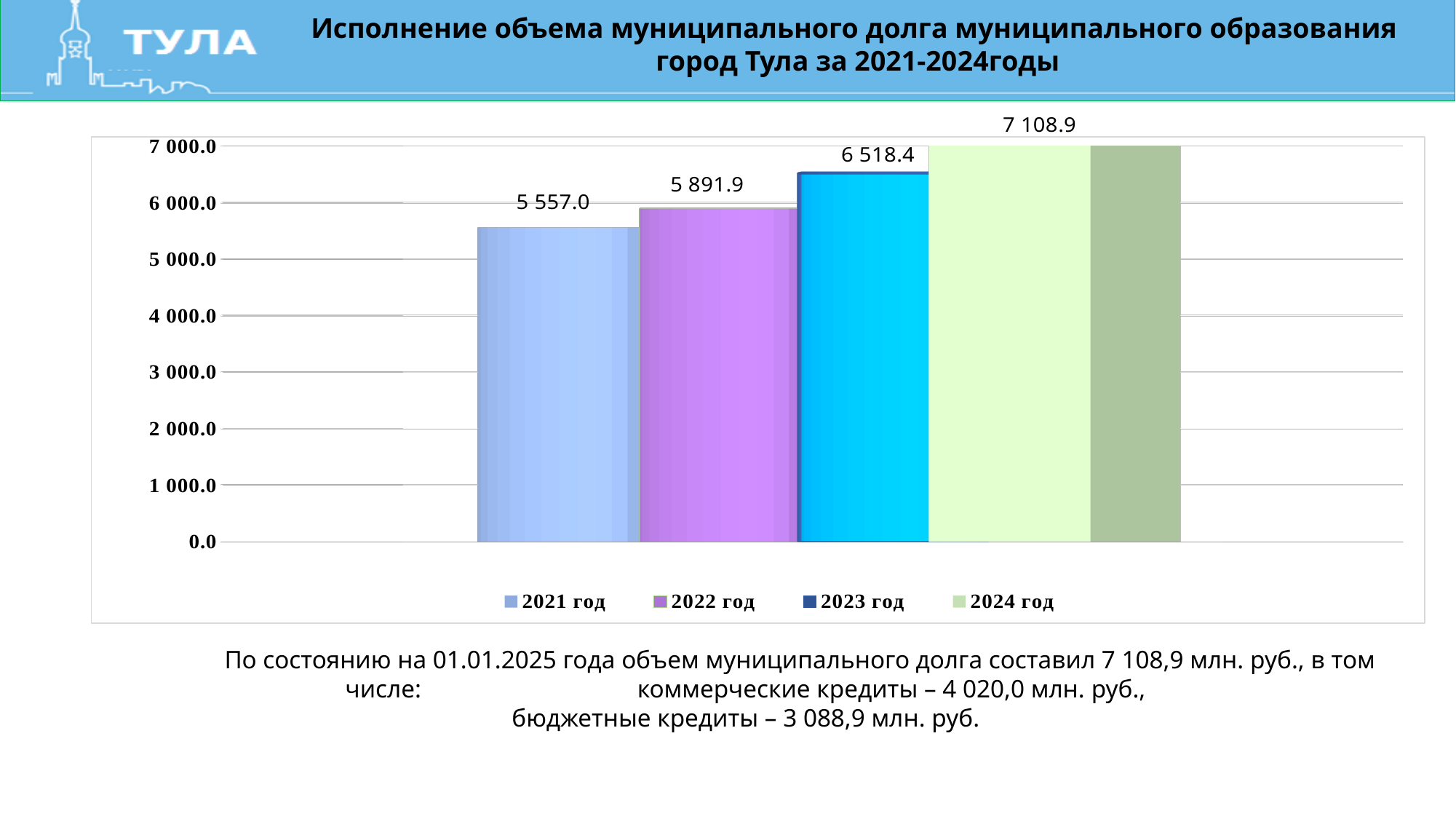
What is the difference between the values for 2024 год and 2021 год? 1 551.9 Do the values rise or fall from 2021 год to 2024 год? Rise What is the value shown for 2022 год? 5 891.9 Which year has the highest value on the chart? 2024 год What is the value shown for 2021 год? 5 557.0 What kind of chart is shown on the slide? Bar chart What is the value shown for 2023 год? 6 518.4 What is the difference between the values for 2023 год and 2022 год? 626.5 How many series does the legend list? 4 Which year has the lowest value on the chart? 2021 год Which is larger, the value for 2022 год or the value for 2023 год? 2023 год What is the value shown for 2024 год? 7 108.9